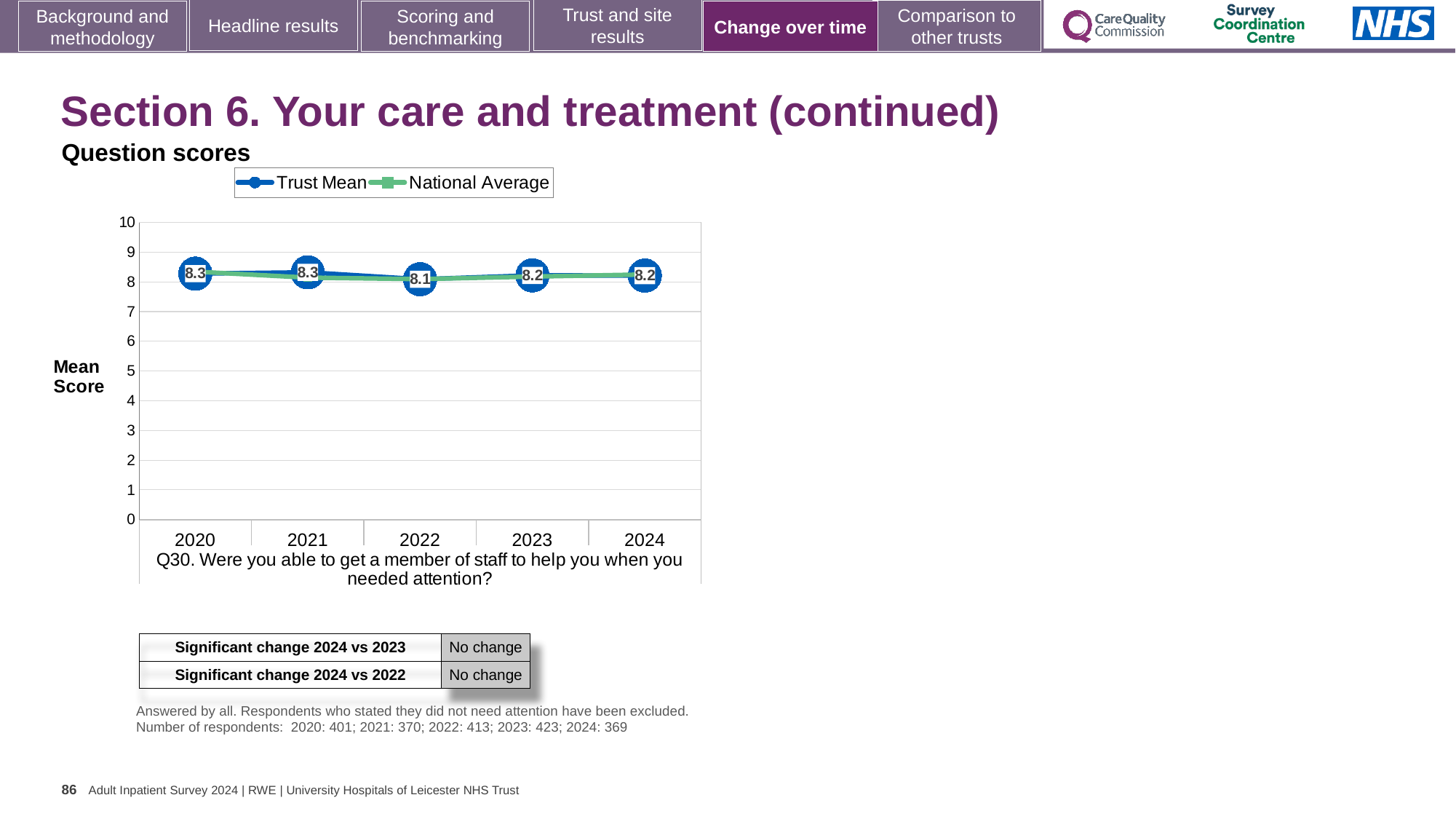
Is the Trust Mean score for 2021 larger or smaller than the Trust Mean score for 2022? larger What is the Trust Mean score for 2023? 8.2 In which year is the Trust Mean score lowest? 2022 What is the Trust Mean score for 2020? 8.3 Is the National Average value for 2022 greater or less than 5? greater What kind of chart is shown? line chart What is the Trust Mean score for 2022? 8.1 How many years are shown on the x axis? 5 What is the difference between the Trust Mean scores for 2021 and 2022? 0.2 What is the label on the y axis? Mean Score How many series does the legend list? 2 What is the Trust Mean score for 2024? 8.2